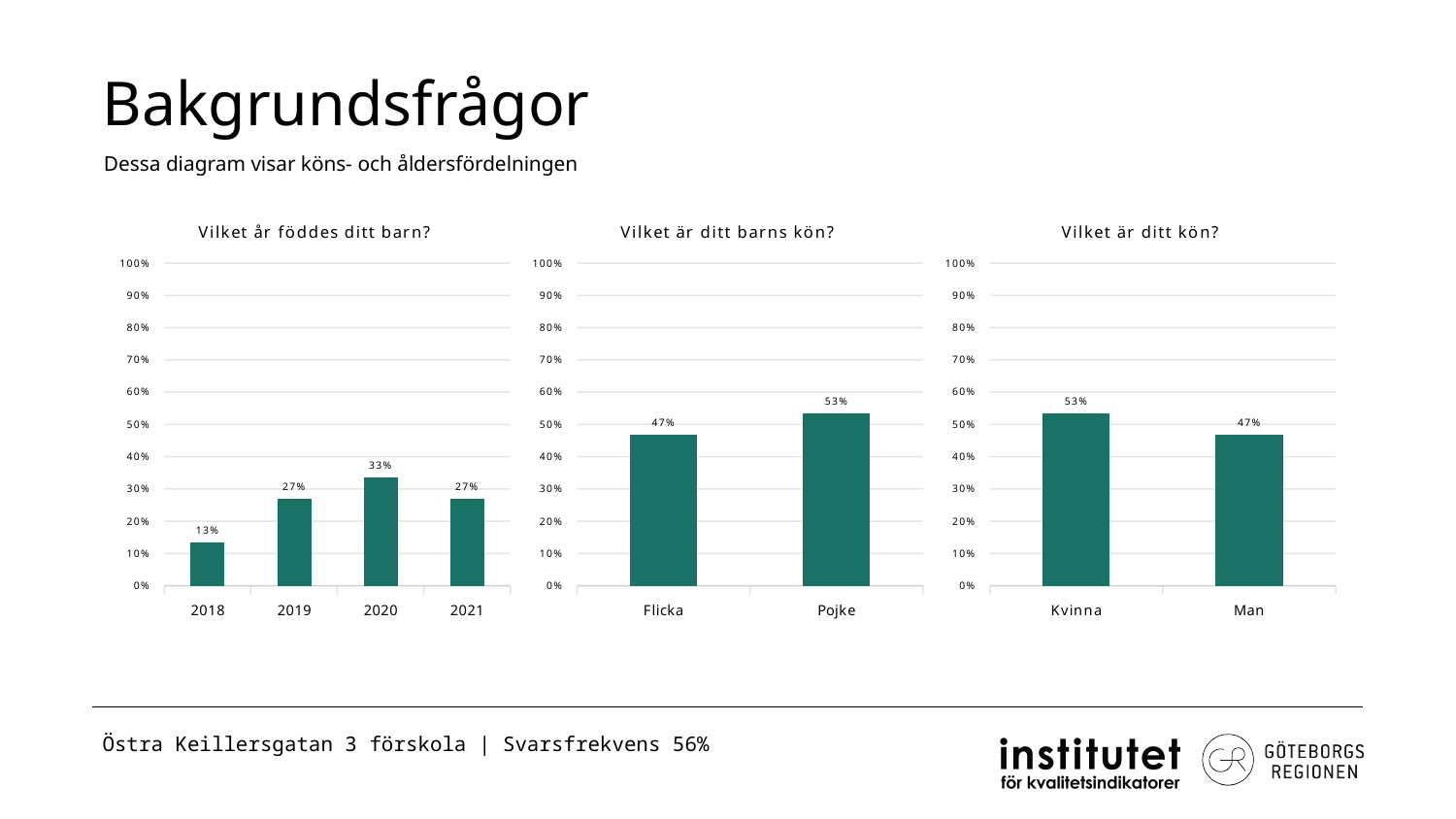
In the chart 'Vilket är ditt kön?', what is the value for Kvinna? 53% In the chart 'Vilket är ditt kön?', which category has the lowest value? Man In the chart 'Vilket år föddes ditt barn?', what is the difference between the values for 2020 and 2018? 20% In the chart 'Vilket år föddes ditt barn?', which year has the highest value? 2020 In the chart 'Vilket år föddes ditt barn?', is the value for 2019 greater or less than 20%? greater In the chart 'Vilket år föddes ditt barn?', what is the value for 2020? 33% In the chart 'Vilket är ditt barns kön?', what is the difference between Pojke and Flicka? 6% In the chart 'Vilket år föddes ditt barn?', which year has the lowest value? 2018 In the chart 'Vilket år föddes ditt barn?', how many years are shown on the x axis? 4 In the chart 'Vilket är ditt barns kön?', what is the value for Pojke? 53% In the chart 'Vilket är ditt barns kön?', which category is larger, Flicka or Pojke? Pojke What kind of chart is 'Vilket är ditt kön?'? Bar chart